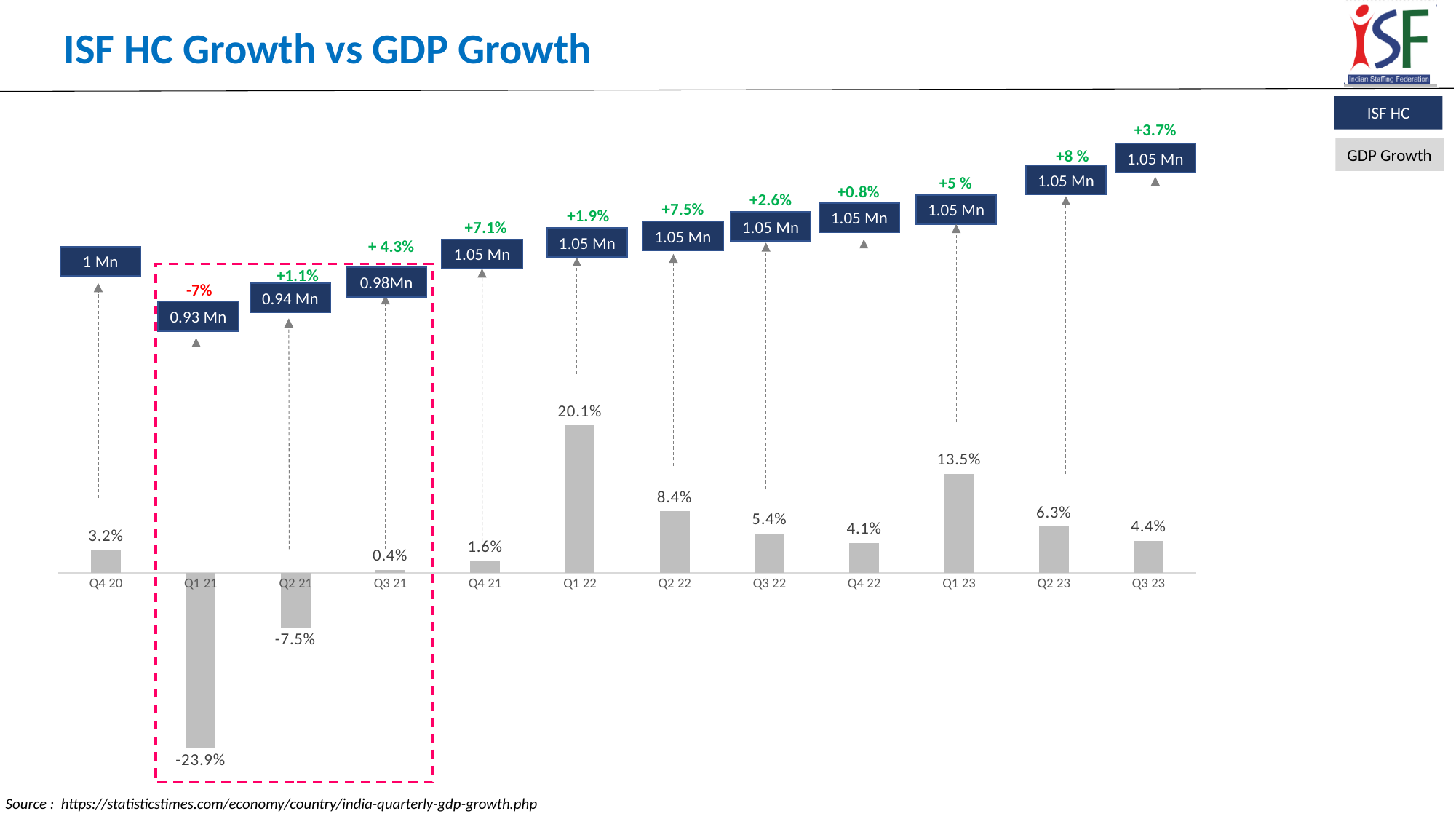
Which quarter has the highest GDP Growth value? Q1 22 What is the ISF HC value for Q3 21? 0.98Mn Which is larger, the GDP Growth value for Q2 22 or for Q3 22? Q2 22 What is the title of the chart? ISF HC Growth vs GDP Growth What is the difference between the GDP Growth values for Q1 23 and Q2 23? 7.2% How many quarters are shown on the x axis? 12 How many series does the legend list? 2 What kind of chart is used to show GDP Growth? Bar chart What is the GDP Growth value for Q1 22? 20.1% Which quarter has the lowest GDP Growth value? Q1 21 What ISF HC growth percentage is shown above Q2 23? +8 % What is the GDP Growth value for Q1 21? -23.9%